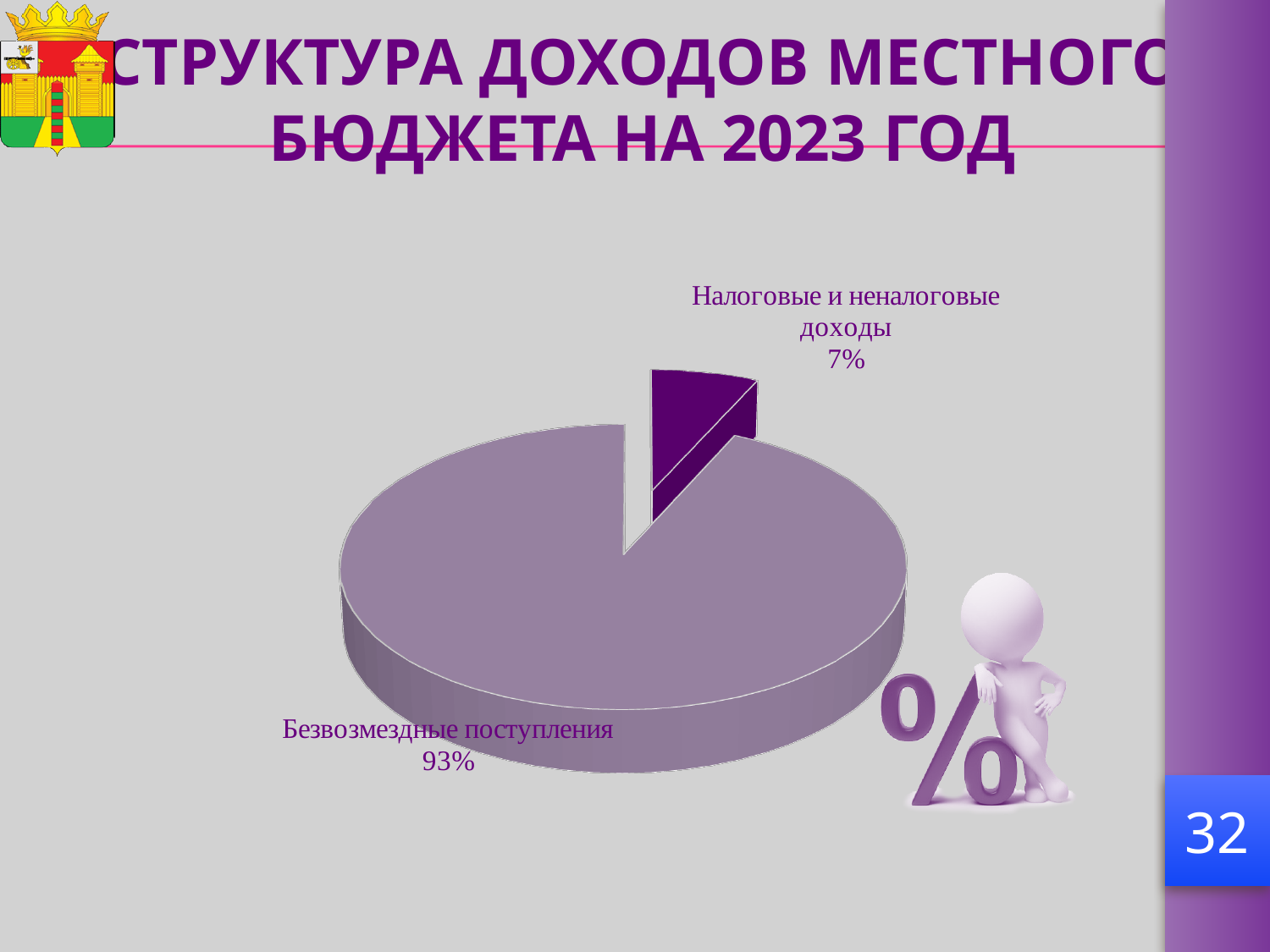
What share of the pie does "Налоговые и неналоговые доходы" represent? 7% How many slices does the pie chart have? 2 What is the difference in percentage points between "Безвозмездные поступления" and "Налоговые и неналоговые доходы"? 86 What share of the pie does "Безвозмездные поступления" represent? 93% What kind of chart is shown on the slide? pie chart Which category has the smallest slice of the pie? Налоговые и неналоговые доходы What is the title of the slide containing the chart? СТРУКТУРА ДОХОДОВ МЕСТНОГО БЮДЖЕТА НА 2023 ГОД Which is larger: the share for "Безвозмездные поступления" or the share for "Налоговые и неналоговые доходы"? Безвозмездные поступления Which slice is shown in the darker purple colour? Налоговые и неналоговые доходы Which category has the largest slice of the pie? Безвозмездные поступления